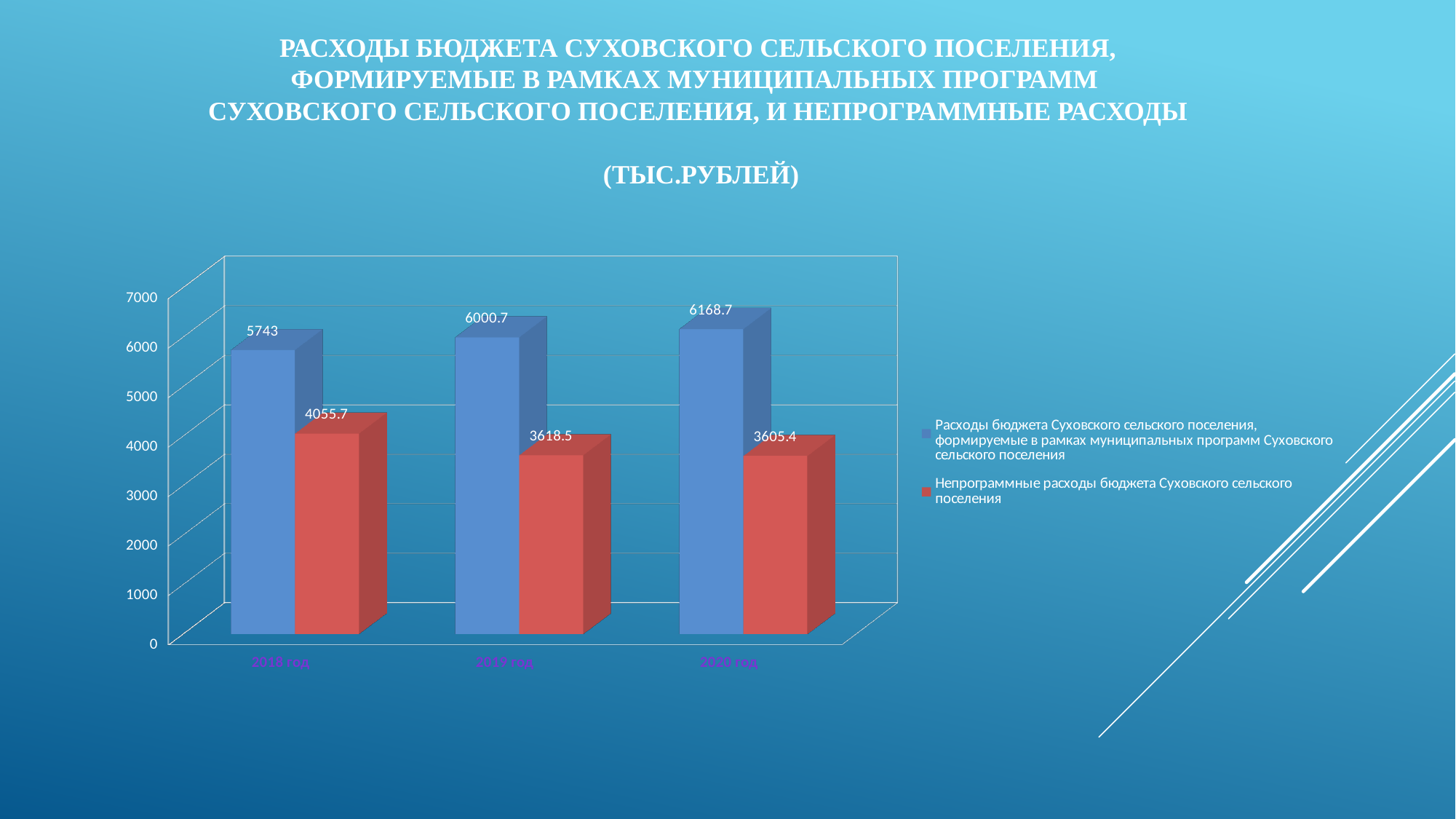
What unit of measurement is stated in the chart title? тыс.рублей What kind of chart is shown on the slide? Bar chart What is the value of the program-based budget expenses (blue series) for 2018 год? 5743 What is the value of the non-program budget expenses (red series) for 2019 год? 3618.5 How many series does the legend list? 2 What is the value of the program-based budget expenses (blue series) for 2020 год? 6168.7 In which year are the non-program budget expenses (red series) lowest? 2020 год Which is larger in 2019 год: the program-based expenses or the non-program expenses? Program-based expenses (6000.7) In which year are the program-based budget expenses (blue series) highest? 2020 год What is the difference between the program-based expenses and the non-program expenses in 2018 год? 1687.3 Do the program-based budget expenses (blue series) rise or fall from 2018 год to 2020 год? Rise How many years (categories) are shown on the x axis? 3